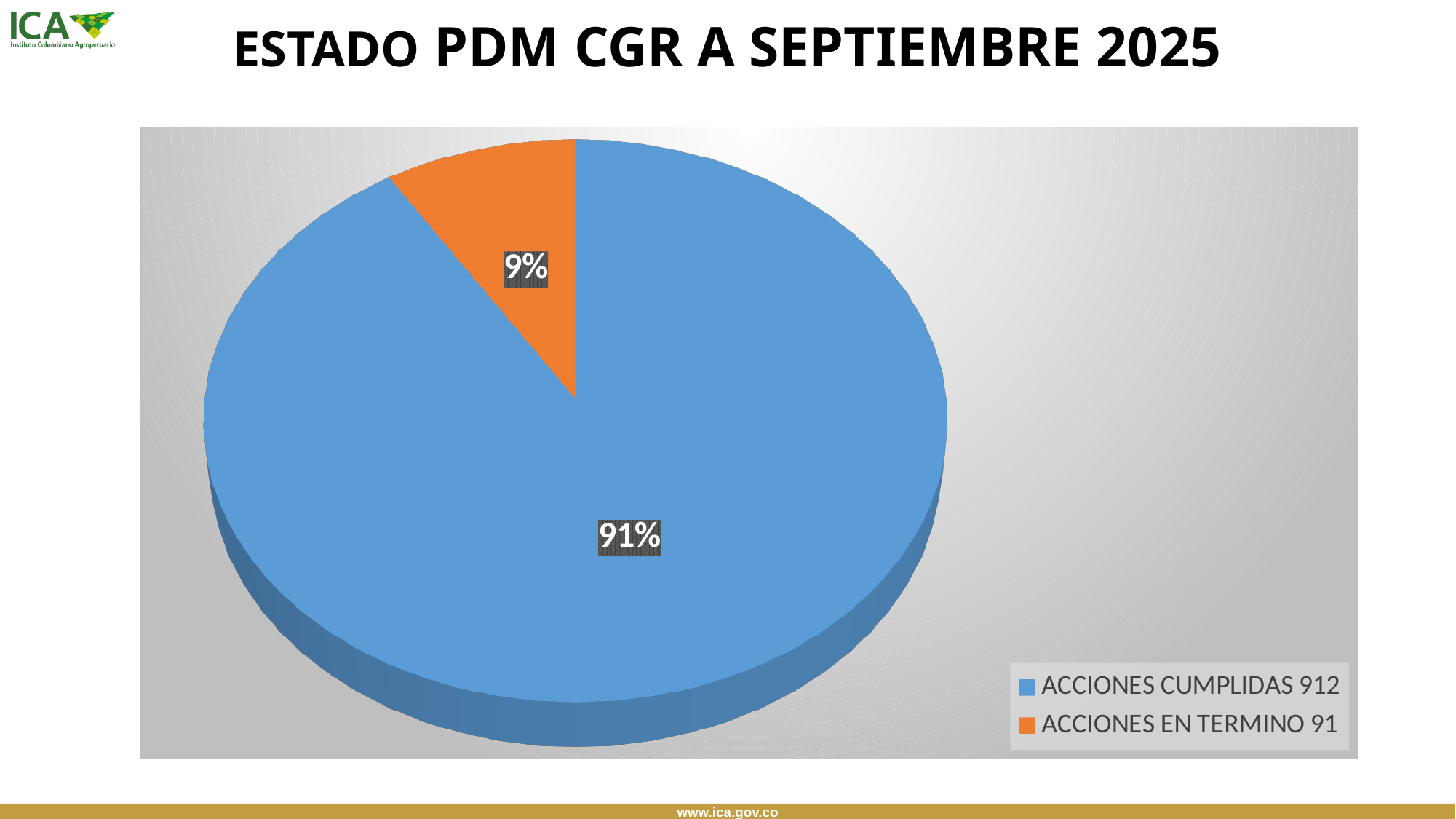
What colour is the ACCIONES EN TERMINO 91 slice? orange Which slice is the largest in the pie chart? ACCIONES CUMPLIDAS 912 What kind of chart is shown on the slide? pie chart What is the difference in percentage points between the ACCIONES CUMPLIDAS slice and the ACCIONES EN TERMINO slice? 82 Which slice is the smallest in the pie chart? ACCIONES EN TERMINO 91 What is the title of the slide containing the chart? ESTADO PDM CGR A SEPTIEMBRE 2025 How many slices does the pie chart have? 2 Which is larger, the ACCIONES CUMPLIDAS slice or the ACCIONES EN TERMINO slice? ACCIONES CUMPLIDAS What percentage share does the ACCIONES CUMPLIDAS 912 slice have? 91% What percentage share does the ACCIONES EN TERMINO 91 slice have? 9% How many entries does the legend list? 2 Is the share of the ACCIONES EN TERMINO slice greater or less than 50%? less